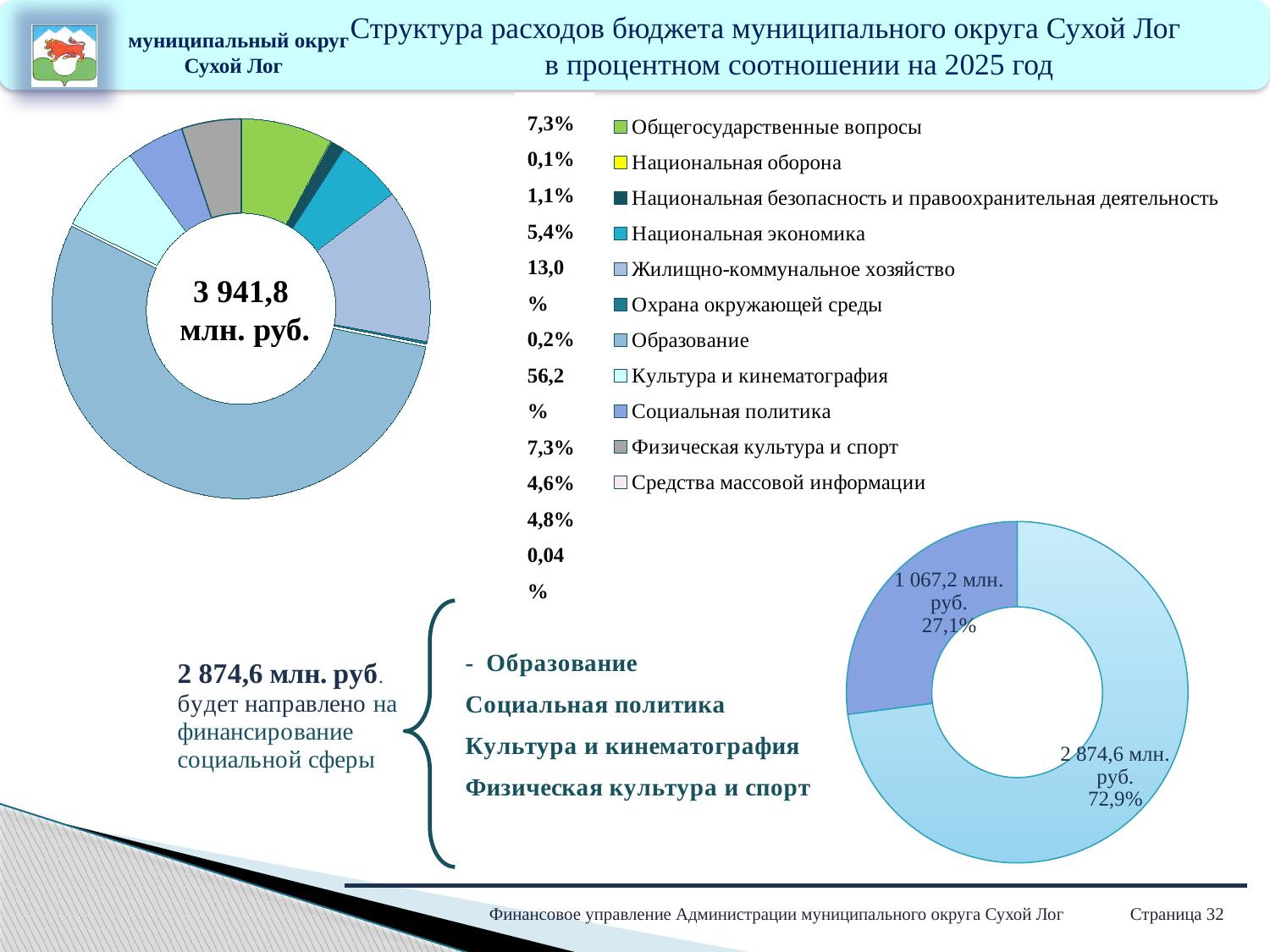
How many slices does the small chart at the bottom right have? 2 In the small chart at the bottom right, what is the difference in млн. руб. between the larger slice (2 874,6) and the smaller slice (1 067,2)? 1 807,4 млн. руб. In the large chart on the left, what percentage share is shown for Образование? 56,2% In the small chart at the bottom right, what percentage share does the smaller slice have? 27,1% What kind of chart is the large chart on the left of the slide? Pie (donut) chart How many categories does the legend of the large chart on the left list? 11 In the small chart at the bottom right, what is the total of the two slices in млн. руб.? 3 941,8 млн. руб. In the small chart at the bottom right, what value is printed on the larger slice? 2 874,6 млн. руб. What total value is printed in the centre of the large chart on the left? 3 941,8 млн. руб. In the small chart at the bottom right, what percentage share does the larger slice have? 72,9% In the large chart on the left, which category has the largest slice? Образование In the large chart on the left, which is larger: the slice for Образование or the slice for Жилищно-коммунальное хозяйство? Образование